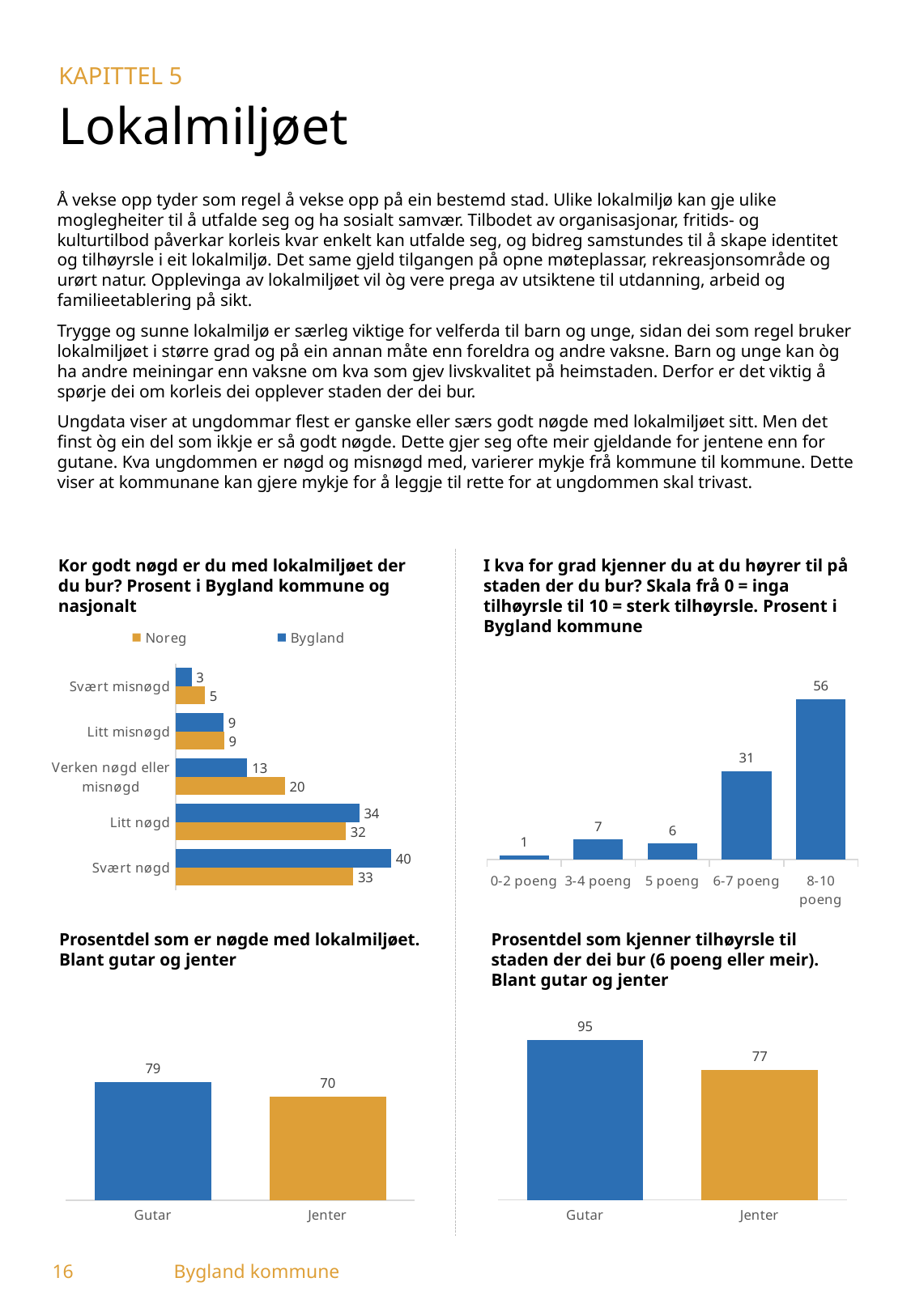
In the top-left chart (Kor godt nøgd er du med lokalmiljøet der du bur?), what is the Bygland value for Svært nøgd? 40 In the top-right chart (I kva for grad kjenner du at du høyrer til på staden der du bur?), which category has the lowest value? 0-2 poeng In the top-right chart (I kva for grad kjenner du at du høyrer til på staden der du bur?), which category has the highest value? 8-10 poeng In the bottom-right chart (Prosentdel som kjenner tilhøyrsle til staden der dei bur), what is the difference between Gutar and Jenter? 18 In the top-right chart (I kva for grad kjenner du at du høyrer til på staden der du bur?), how many categories are shown on the x axis? 5 In the top-right chart (I kva for grad kjenner du at du høyrer til på staden der du bur?), what is the value for 6-7 poeng? 31 What kind of chart is the bottom-right chart (Prosentdel som kjenner tilhøyrsle til staden der dei bur)? Bar chart In the top-left chart (Kor godt nøgd er du med lokalmiljøet der du bur?), what is the Noreg value for Verken nøgd eller misnøgd? 20 In the top-left chart (Kor godt nøgd er du med lokalmiljøet der du bur?), which series is shown in orange? Noreg In the bottom-left chart (Prosentdel som er nøgde med lokalmiljøet), what is the value for Jenter? 70 In the top-left chart (Kor godt nøgd er du med lokalmiljøet der du bur?), how many series does the legend list? 2 In the top-left chart (Kor godt nøgd er du med lokalmiljøet der du bur?), what is the difference between the Noreg and Bygland values for Svært nøgd? 7